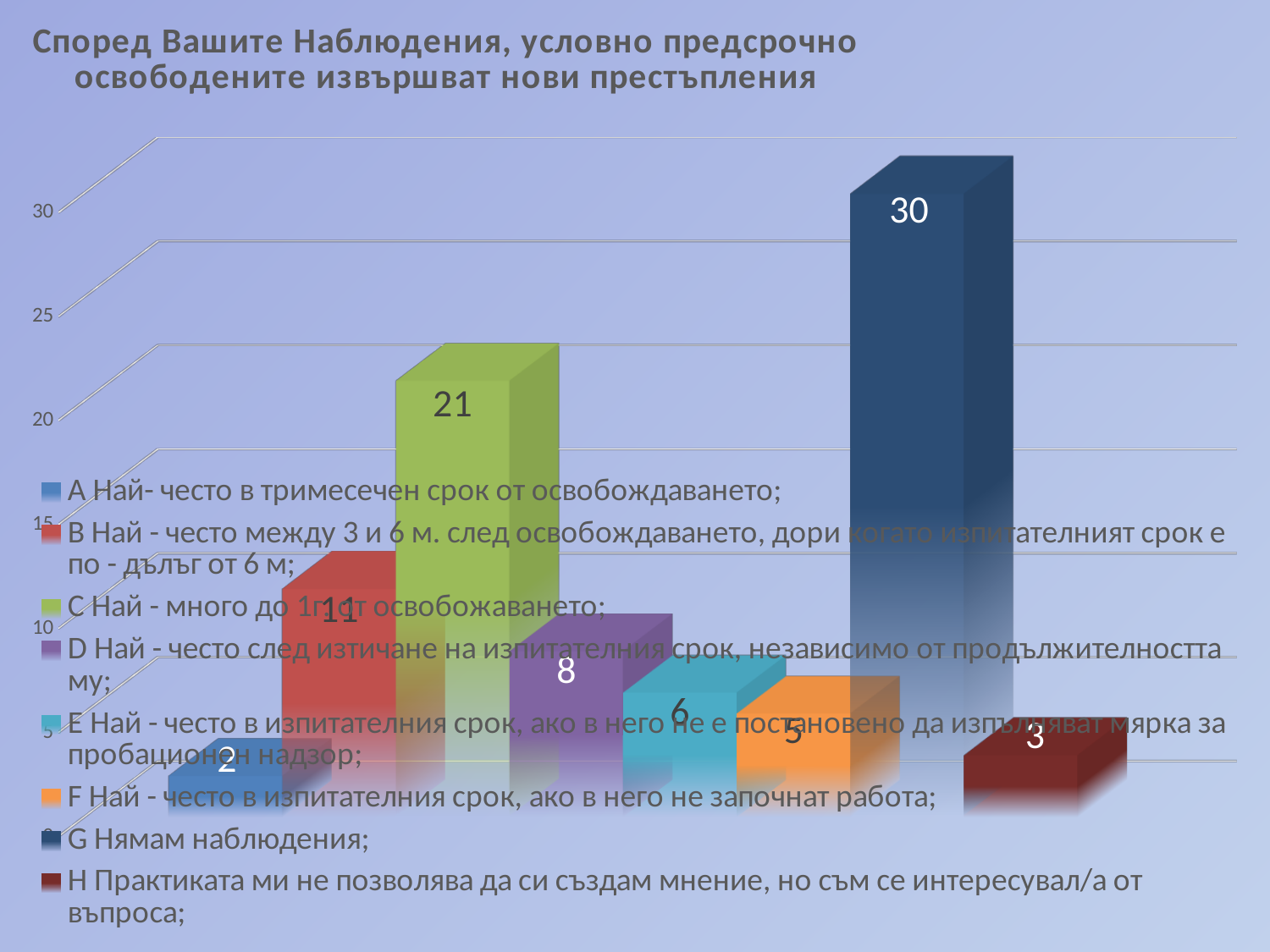
How many entries does the legend list? 8 Which is larger, the value for E or the value for H? E How many bars are plotted in the chart? 8 What value is shown for the bar labelled A (Най- често в тримесечен срок от освобождаването)? 2 Which legend category has the lowest value? A Най- често в тримесечен срок от освобождаването What is the difference between the values for B (11) and F (5)? 6 What is the difference between the values for G (30) and C (21)? 9 What kind of chart is shown on the slide? Bar chart What value is shown for the bar labelled C (Най - много до 1г. от освобожаването)? 21 What value is shown for the bar labelled G (Нямам наблюдения)? 30 Which legend category has the highest value? G Нямам наблюдения What value is shown for the bar labelled D (Най - често след изтичане на изпитателния срок)? 8